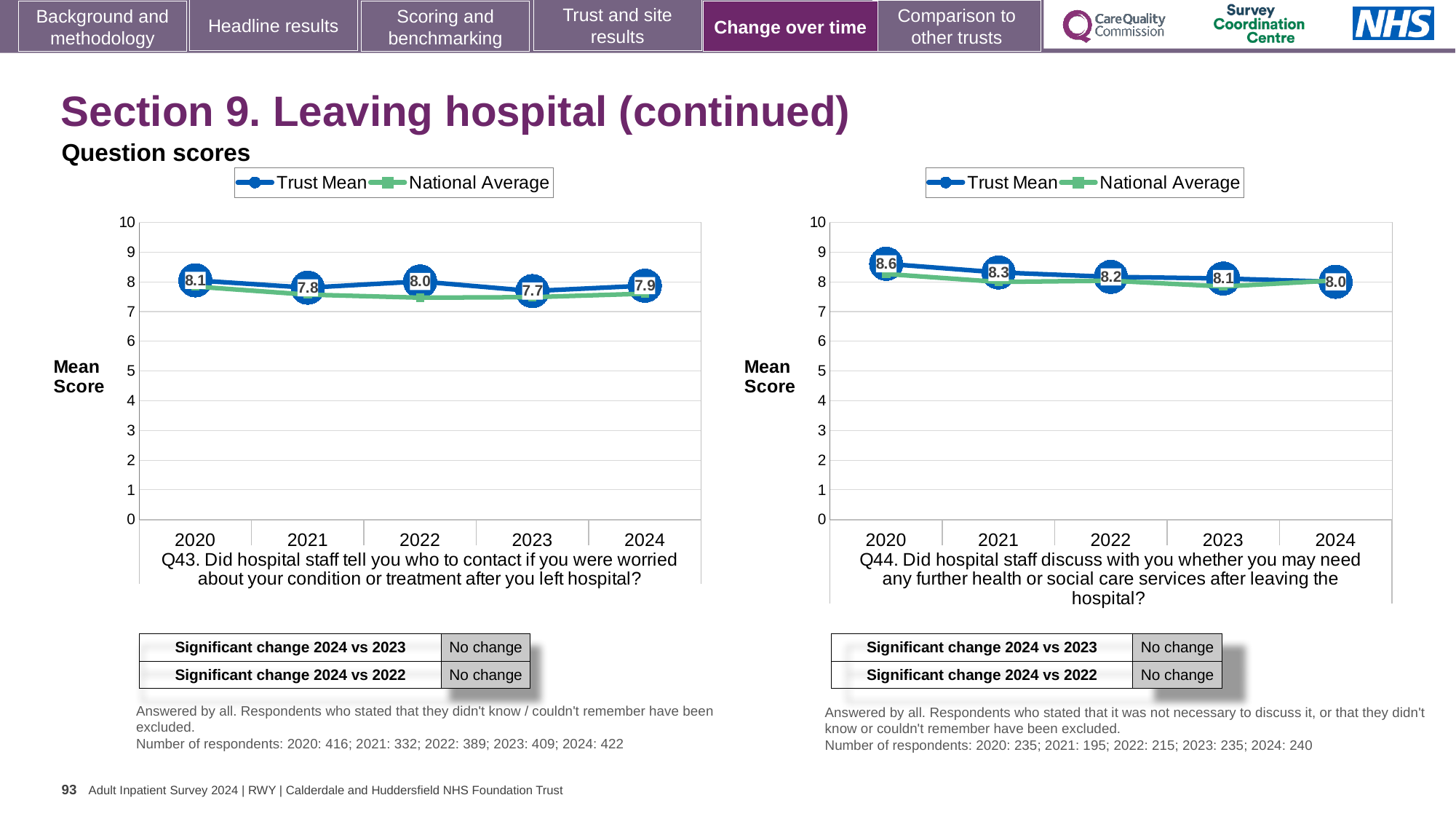
In the Q43 chart (left), is the Trust Mean score higher in 2022 or in 2023? 2022 How many series does the legend of the Q44 chart (right) list? 2 In the Q44 chart (right), what is the Trust Mean score for 2024? 8.0 In the Q44 chart (right), what is the difference between the Trust Mean scores for 2020 and 2024? 0.6 In the Q43 chart (left), what is the Trust Mean score for 2020? 8.1 How many years are plotted on the x axis of the Q43 chart (left)? 5 In the Q43 chart (left), which year has the lowest Trust Mean score? 2023 In the Q44 chart (right), which year has the highest Trust Mean score? 2020 In the Q44 chart (right), does the Trust Mean score rise or fall from 2020 to 2024? fall What kind of chart is used for Q43 (left)? line chart What are the two series named in the legend of the Q43 chart (left)? Trust Mean and National Average In the Q44 chart (right), is the National Average value for 2020 greater or less than 9? less